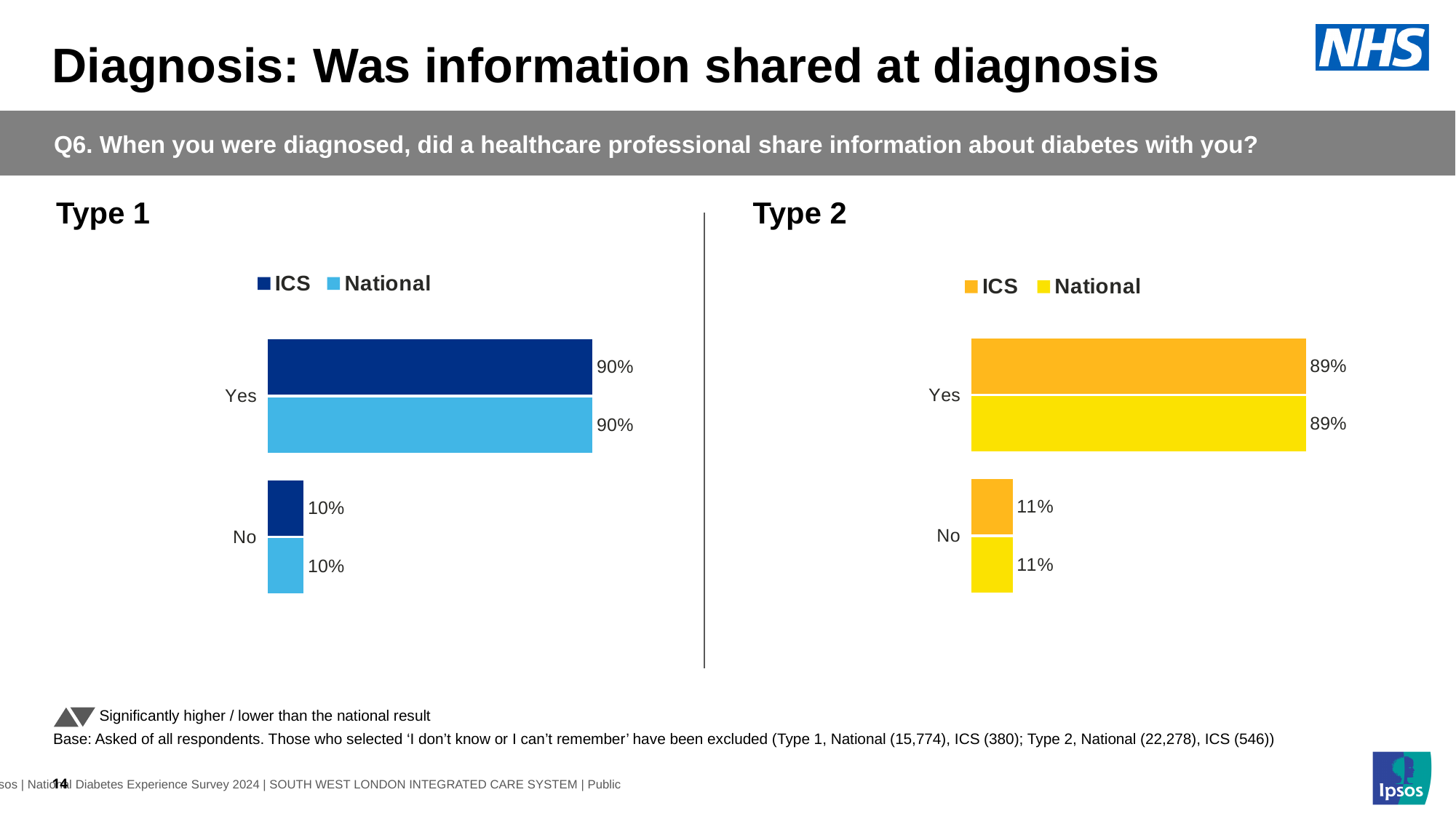
In the Type 2 chart, what is the ICS value for Yes? 89% In the Type 2 chart, what is the National value for No? 11% In the Type 2 chart, which is larger: the ICS value for Yes or the ICS value for No? Yes In the Type 1 chart, which category has the lowest National value? No In the Type 1 chart, what is the National value for No? 10% How many categories are shown in the Type 1 chart? 2 In the Type 1 chart, what is the ICS value for Yes? 90% In the Type 1 chart, what is the difference between the ICS values for Yes and No? 80% How many series does the legend of the Type 2 chart list? 2 In the Type 2 chart, what is the difference between the National values for Yes and No? 78% What kind of chart is the Type 1 chart? Bar chart In the Type 2 chart, which category has the highest ICS value? Yes